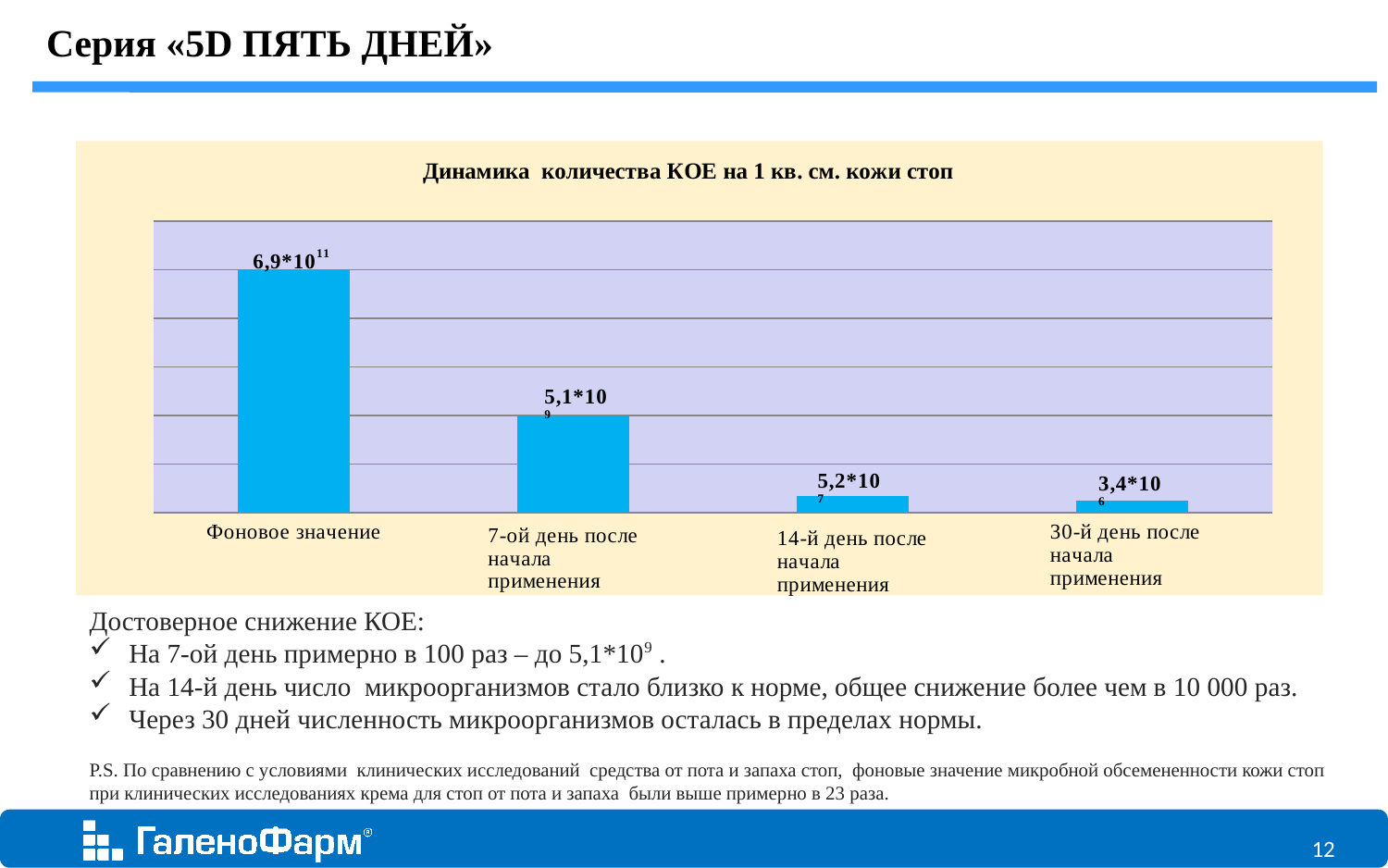
What is the title of the chart? Динамика количества КОЕ на 1 кв. см. кожи стоп Which category has the highest value? Фоновое значение What type of chart is shown on the slide? bar chart How many categories are plotted in the chart? 4 What is the value for «7-ой день после начала применения»? 5,1*10⁹ What is the value for «30-й день после начала применения»? 3,4*10⁶ Which is larger: the value for «7-ой день после начала применения» or for «14-й день после начала применения»? 7-ой день после начала применения What is the value for «Фоновое значение»? 6,9*10¹¹ Which category has the lowest value? 30-й день после начала применения What colour are the bars in the chart? blue What is the value for «14-й день после начала применения»? 5,2*10⁷ Do the values rise or fall from left to right along the x axis? fall